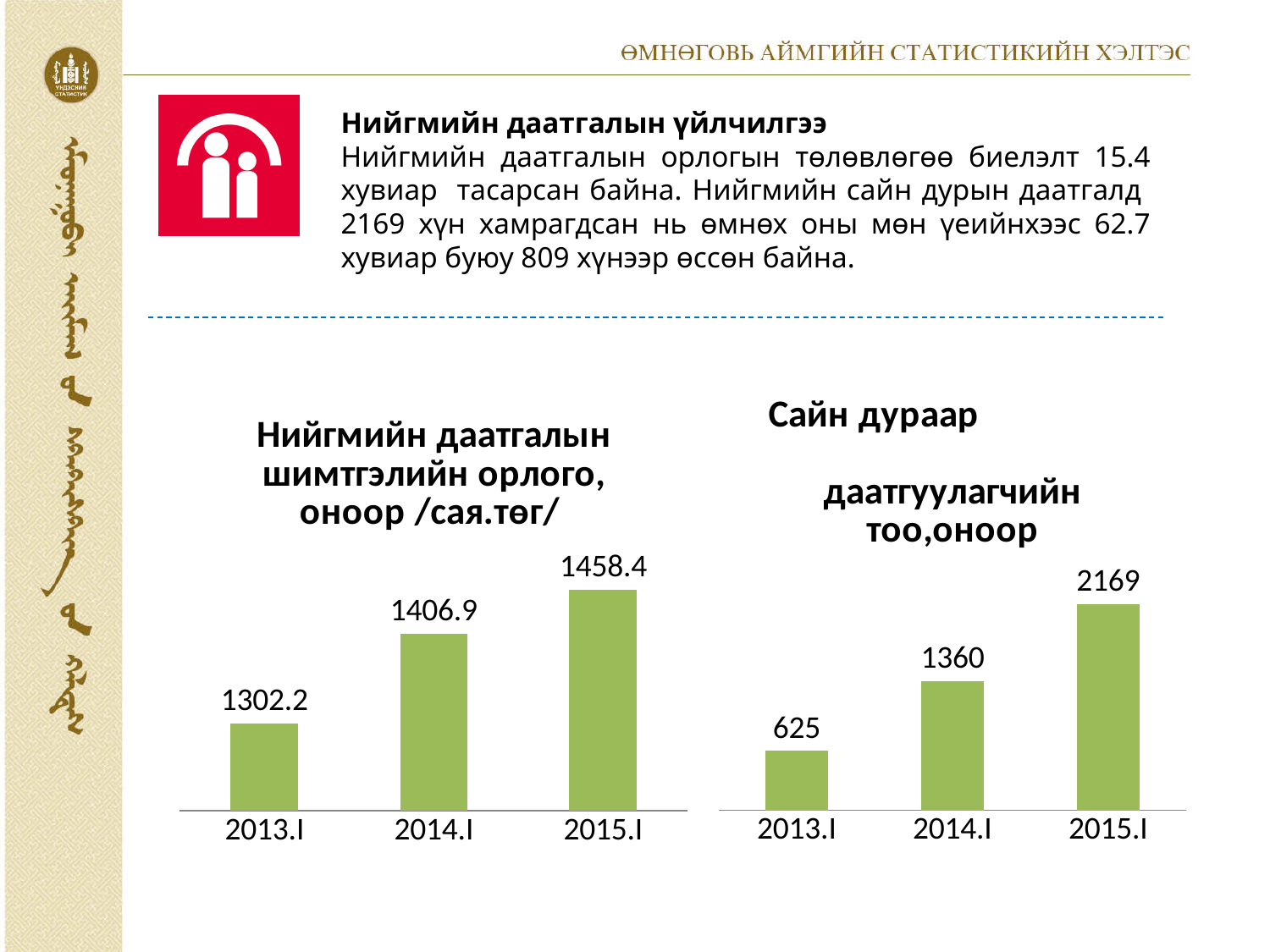
In the left chart (Нийгмийн даатгалын шимтгэлийн орлого), what is the difference between the 2015.I and 2013.I values? 156.2 How many bars are shown in the left chart (Нийгмийн даатгалын шимтгэлийн орлого)? 3 In the left chart (Нийгмийн даатгалын шимтгэлийн орлого), what is the value for 2013.I? 1302.2 In the left chart (Нийгмийн даатгалын шимтгэлийн орлого), which year has the highest value? 2015.I In the left chart (Нийгмийн даатгалын шимтгэлийн орлого), what is the value for 2015.I? 1458.4 In the right chart (Сайн дураар даатгуулагчийн тоо), what is the difference between the 2015.I and 2014.I values? 809 In the right chart (Сайн дураар даатгуулагчийн тоо), what is the value for 2014.I? 1360 In the right chart (Сайн дураар даатгуулагчийн тоо), which is larger, the value for 2014.I or 2013.I? 2014.I In the right chart (Сайн дураар даатгуулагчийн тоо), what is the value for 2013.I? 625 What type of chart is the right chart (Сайн дураар даатгуулагчийн тоо)? Bar chart In the right chart (Сайн дураар даатгуулагчийн тоо), which year has the lowest value? 2013.I In the right chart (Сайн дураар даатгуулагчийн тоо), do the values rise or fall from 2013.I to 2015.I? Rise